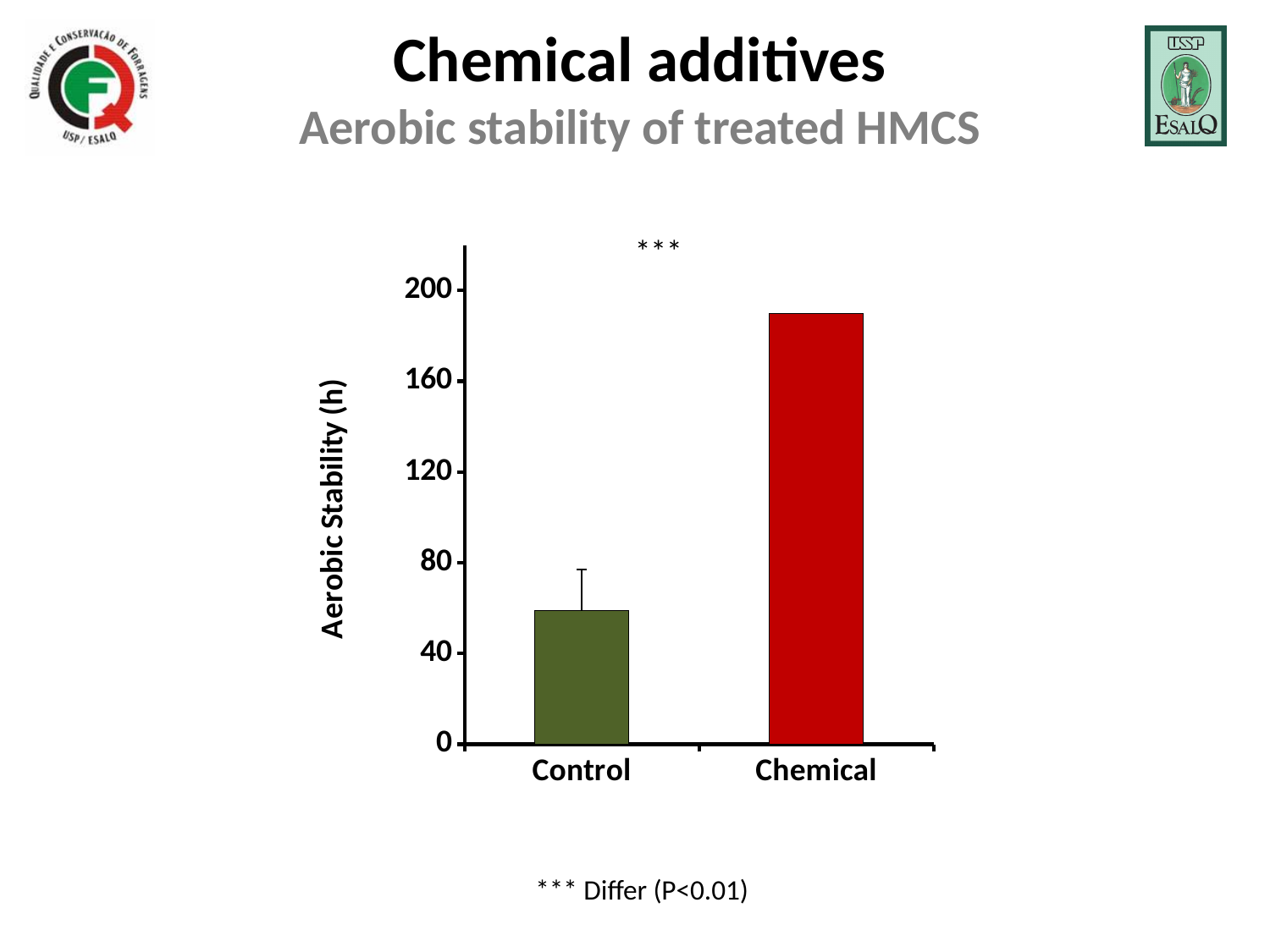
Which category has the lowest aerobic stability? Control Which has a larger aerobic stability value, Control or Chemical? Chemical Is the value for Control greater or less than 80? less What colour is the bar for Chemical? red What kind of chart is shown on the slide? bar chart Which category has the highest aerobic stability? Chemical Do the values rise or fall from Control to Chemical along the x axis? rise Is the value for Chemical greater or less than 200? less Is the value for Chemical greater or less than 160? greater What is the title of the y axis of the chart? Aerobic Stability (h) How many categories are plotted on the x axis of the chart? 2